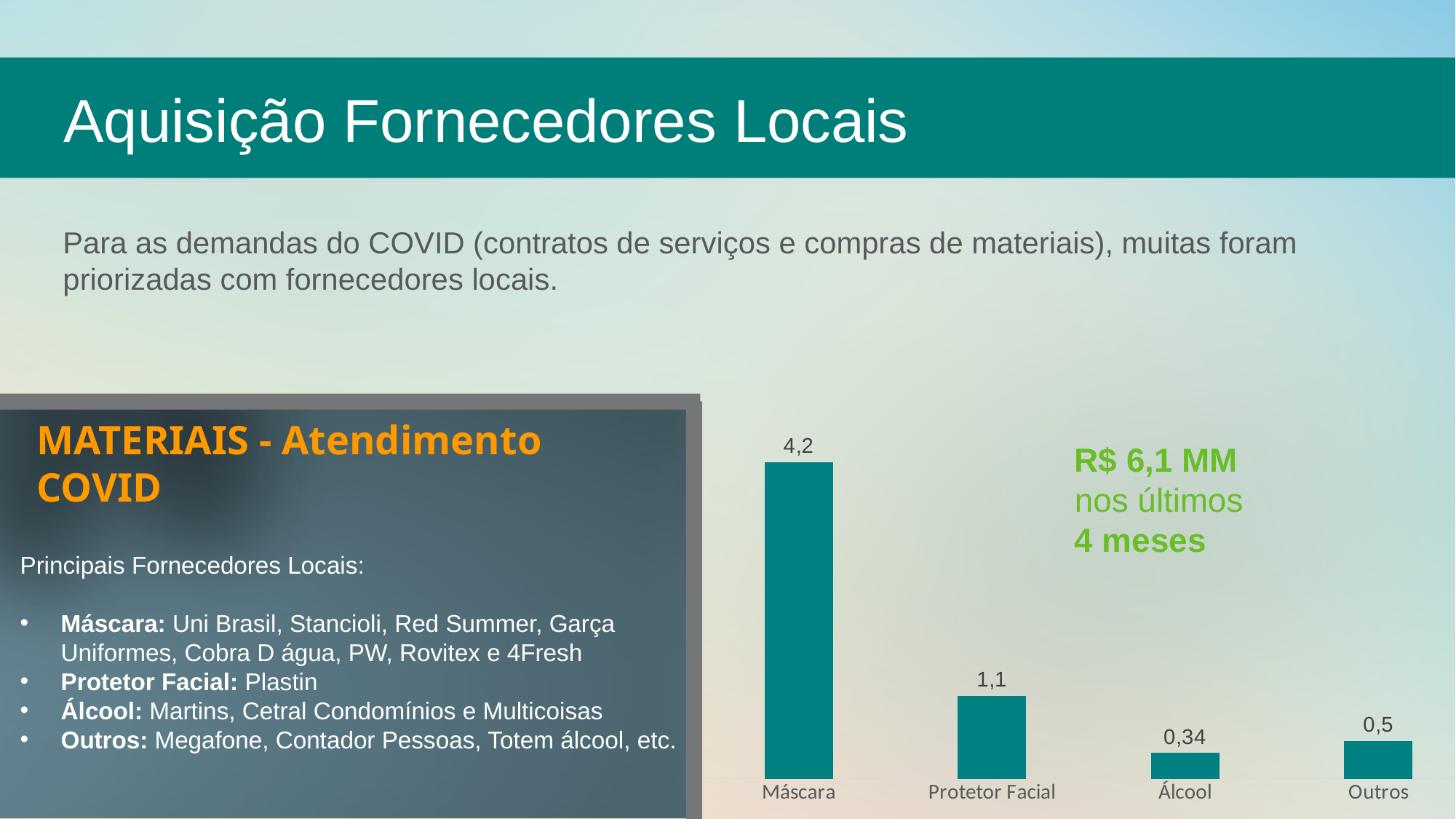
Which is larger, the value for Outros or the value for Álcool? Outros What is the value for Outros? 0,5 What is the value for Protetor Facial? 1,1 Which category has the highest value? Máscara What total amount is stated in the green annotation next to the chart? R$ 6,1 MM What is the difference between the values for Máscara and Protetor Facial? 3,1 What is the value for Álcool? 0,34 Which category has the lowest value? Álcool What is the value for Máscara? 4,2 What is the difference between the values for Outros and Álcool? 0,16 How many categories are shown in the chart? 4 What kind of chart is shown on the slide? Bar chart